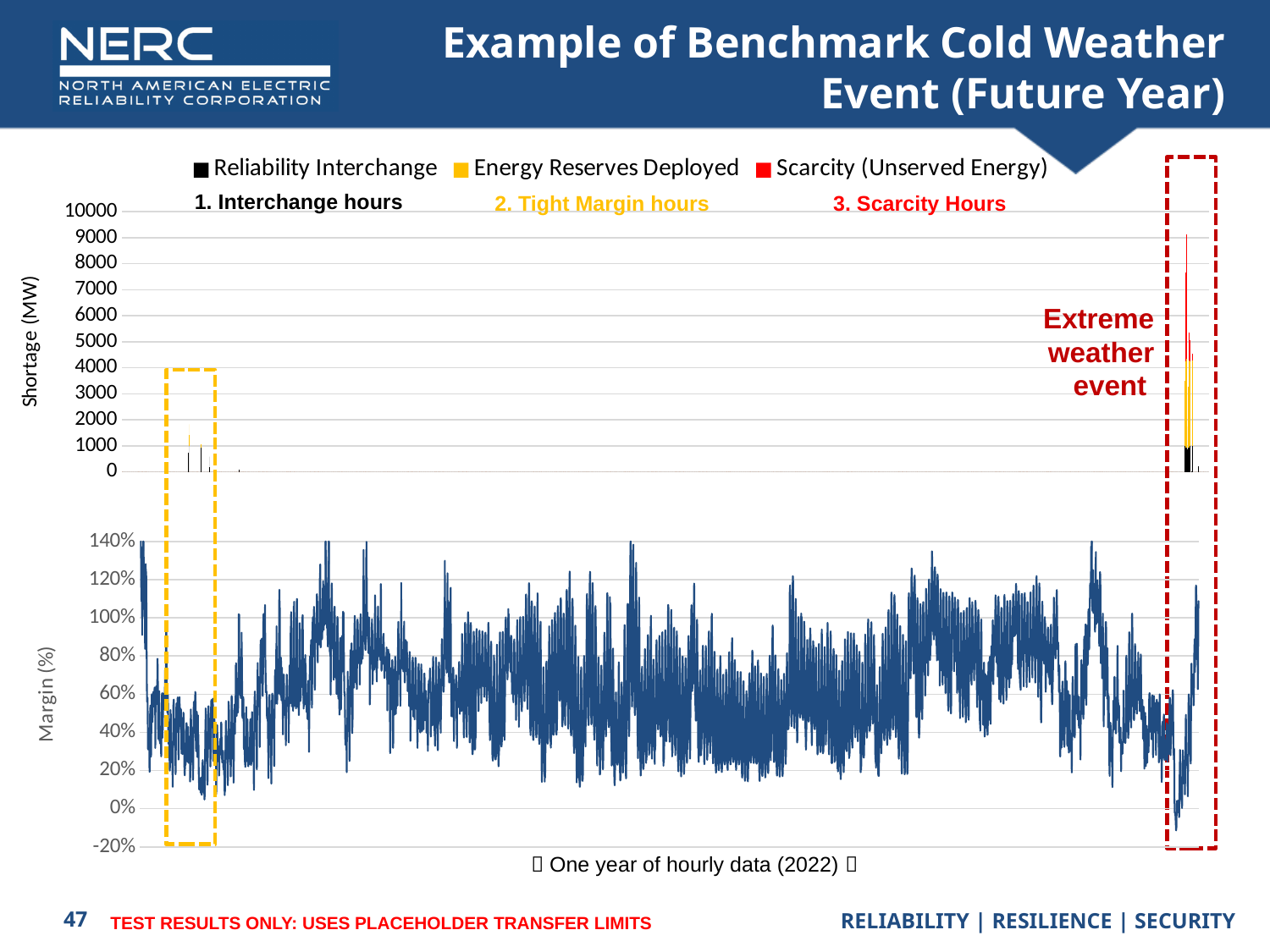
What is the maximum value shown on the y axis of the top chart? 10000 What kind of chart is the top chart (Shortage (MW))? bar chart What is the y-axis label of the bottom chart? Margin (%) In the bottom chart, is the highest margin value reached during the year greater or less than 120%? greater How many series does the legend of the top chart list? 3 In the top chart, are the shortage bars inside the yellow dashed box near the start of the year greater or less than 2000? less What is the minimum value shown on the y axis of the bottom chart? -20% In the top chart, which series is shown in red? Scarcity (Unserved Energy) In the bottom chart, is the lowest margin value during the extreme weather event greater or less than 0%? less In the top chart, which series is shown in yellow? Energy Reserves Deployed What kind of chart is the bottom chart (Margin (%))? line chart